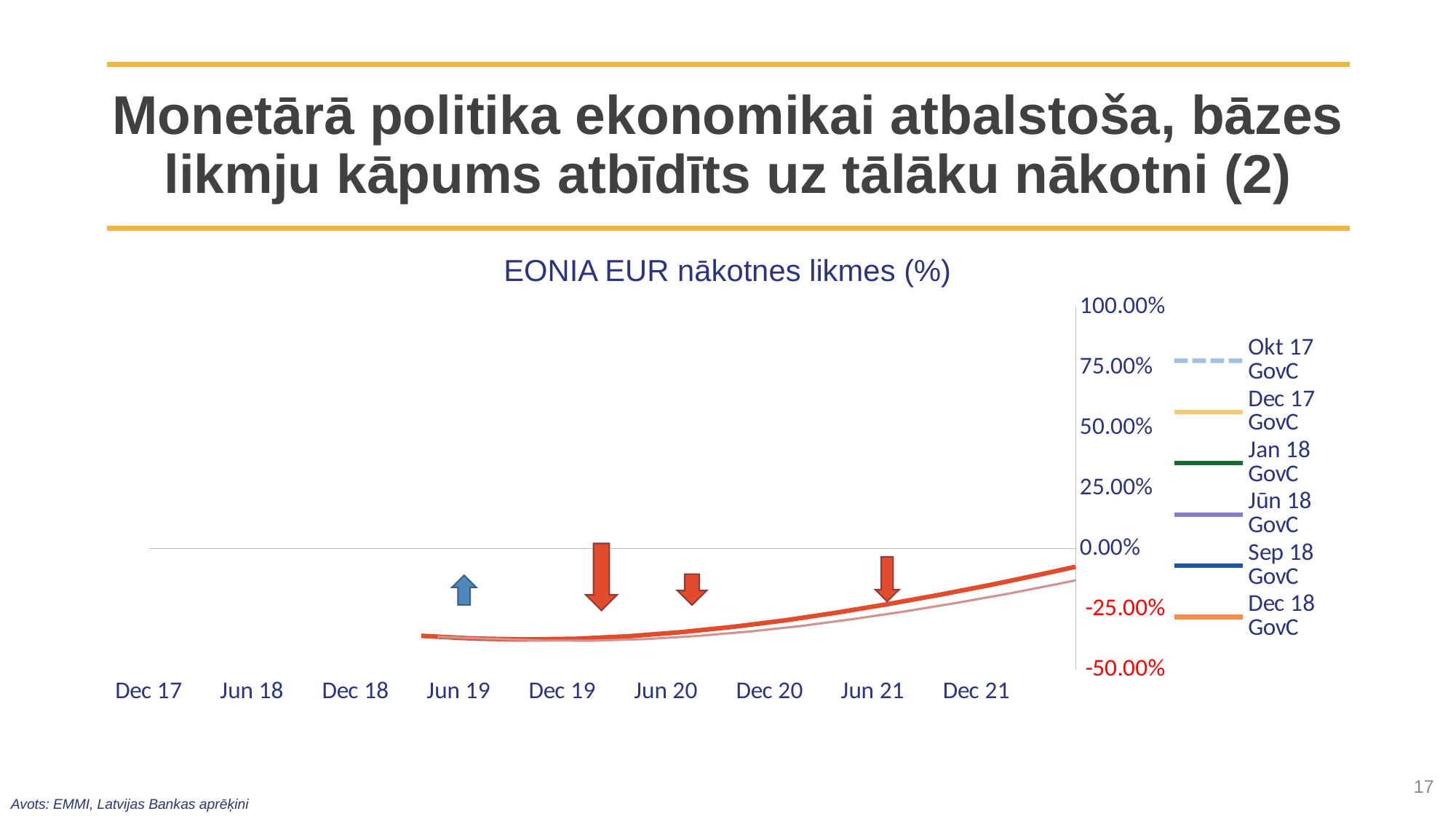
What is the title of the chart? EONIA EUR nākotnes likmes (%) How many date labels are shown along the x axis? 9 What is the highest value shown on the y axis? 100.00% Is the value of the plotted line at Dec 21 greater or less than -25.00%? greater Is the value of the plotted line at Dec 21 greater or less than 0.00%? less At which x-axis label does the plotted line reach its highest value? Dec 21 What kind of chart is shown on the slide? line chart Does the plotted line rise or fall from Jun 19 to Dec 21? rises Which legend entry is drawn with a dashed line? Okt 17 GovC How many series does the chart's legend list? 6 Is the value of the plotted line at Jun 19 greater or less than -25.00%? less Is the plotted line's value at Dec 21 larger or smaller than its value at Jun 19? larger